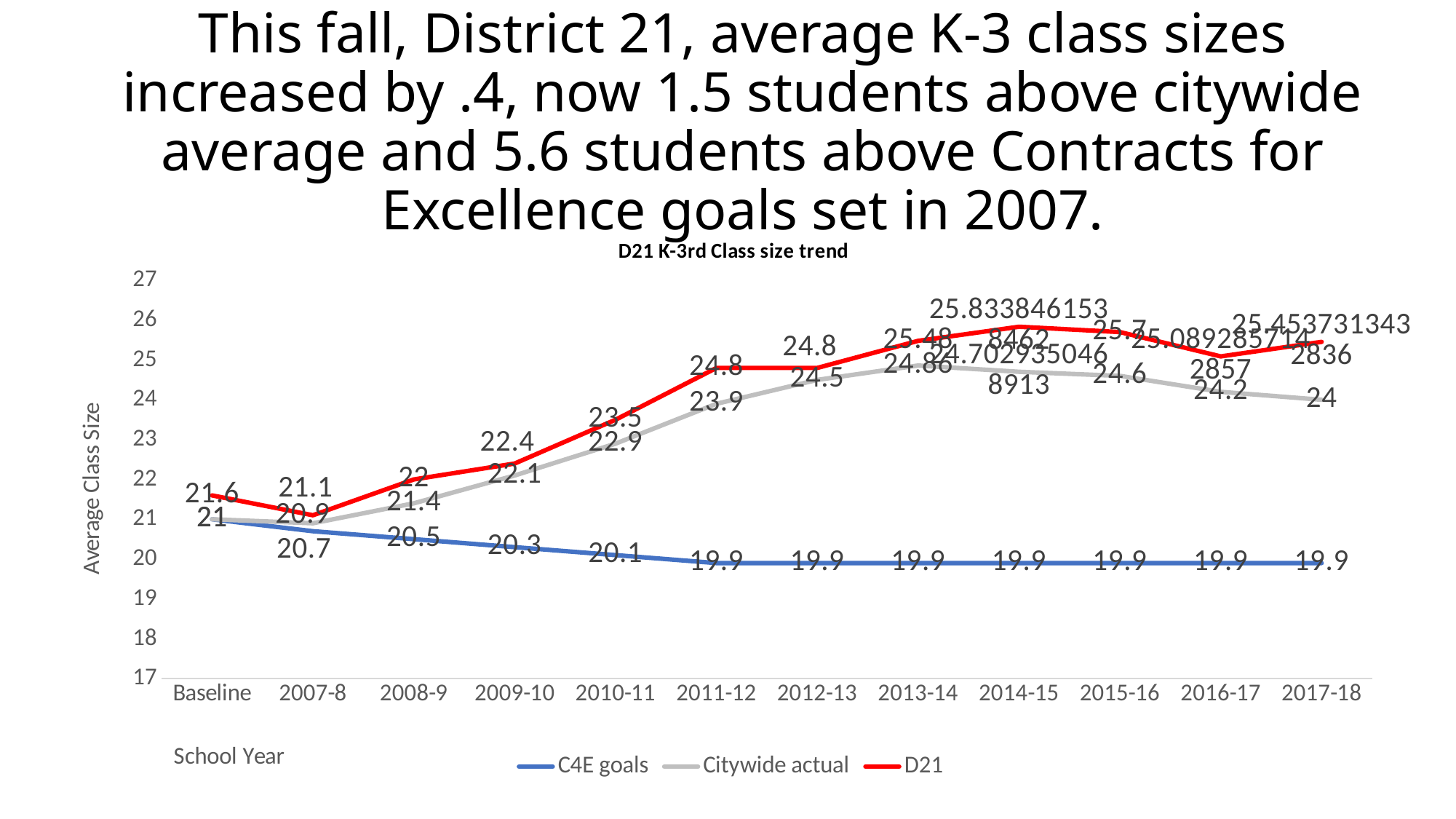
What is the D21 value at Baseline? 21.6 What is the Citywide actual value for 2017-18? 24 What is the D21 value for 2011-12? 24.8 What kind of chart is shown on the slide? Line chart Is the D21 value for 2014-15 greater or less than 25? greater How many school-year categories are shown on the x axis? 12 What is the C4E goals value for 2017-18? 19.9 What is the title of the chart? D21 K-3rd Class size trend What is the difference between the D21 value and the Citywide actual value in 2011-12? 0.9 How many series does the legend list? 3 Do the C4E goals values rise or fall from Baseline to 2017-18? Fall Which is larger in 2017-18, the D21 value or the Citywide actual value? D21